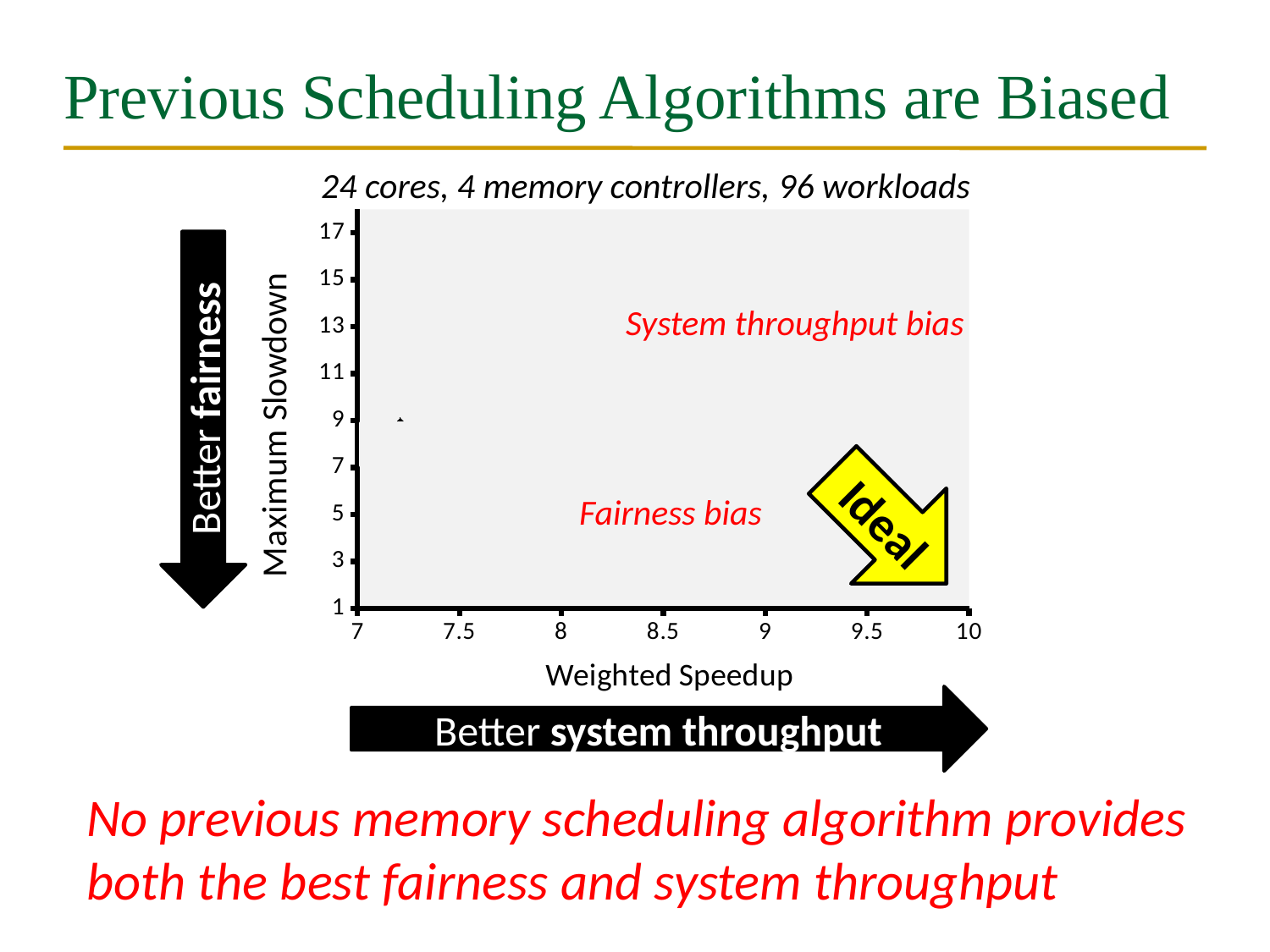
Is the Maximum Slowdown of the plotted point greater or less than 7? greater What is the title of the x axis of the chart? Weighted Speedup Is the Maximum Slowdown of the plotted point greater or less than 11? less What kind of chart is shown on the slide? scatter chart What is the title of the y axis of the chart? Maximum Slowdown Is the Weighted Speedup of the plotted point greater or less than 7.5? less How many data points are plotted on the chart? 1